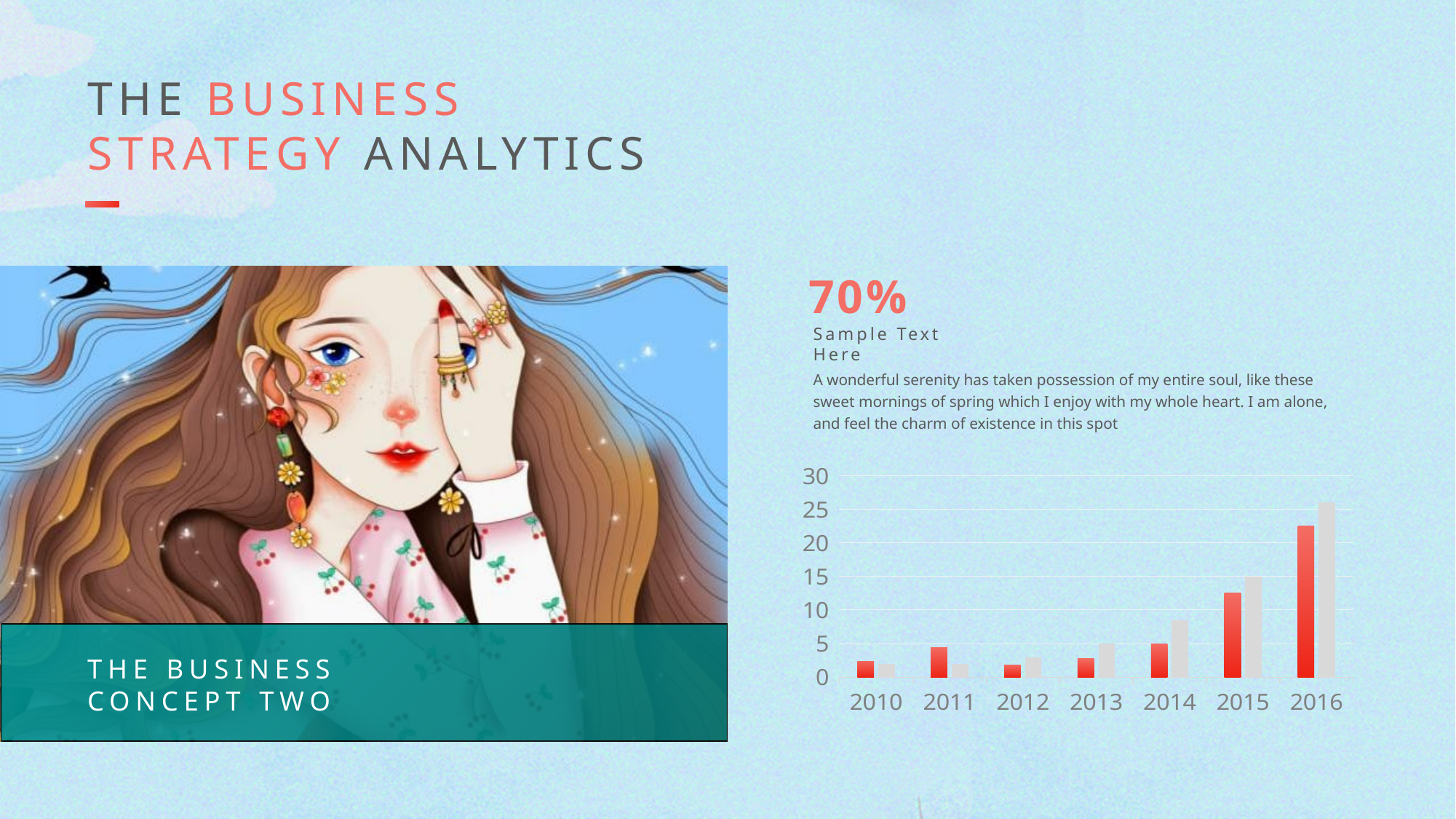
How many bars are plotted for each year in the chart? 2 Is the value of the red bar for 2016 greater or less than 20? greater What kind of chart is shown on the slide? bar chart Which year has the tallest red bar in the chart? 2016 For 2016, which bar is taller, the red one or the grey one? the grey one Do the grey bars generally rise or fall from 2010 to 2016? rise How many years are shown on the x axis of the chart? 7 Is the value of the grey bar for 2014 greater or less than 10? less Which year has the tallest grey bar in the chart? 2016 For 2011, which bar is taller, the red one or the grey one? the red one Is the value of the red bar for 2015 greater or less than 10? greater